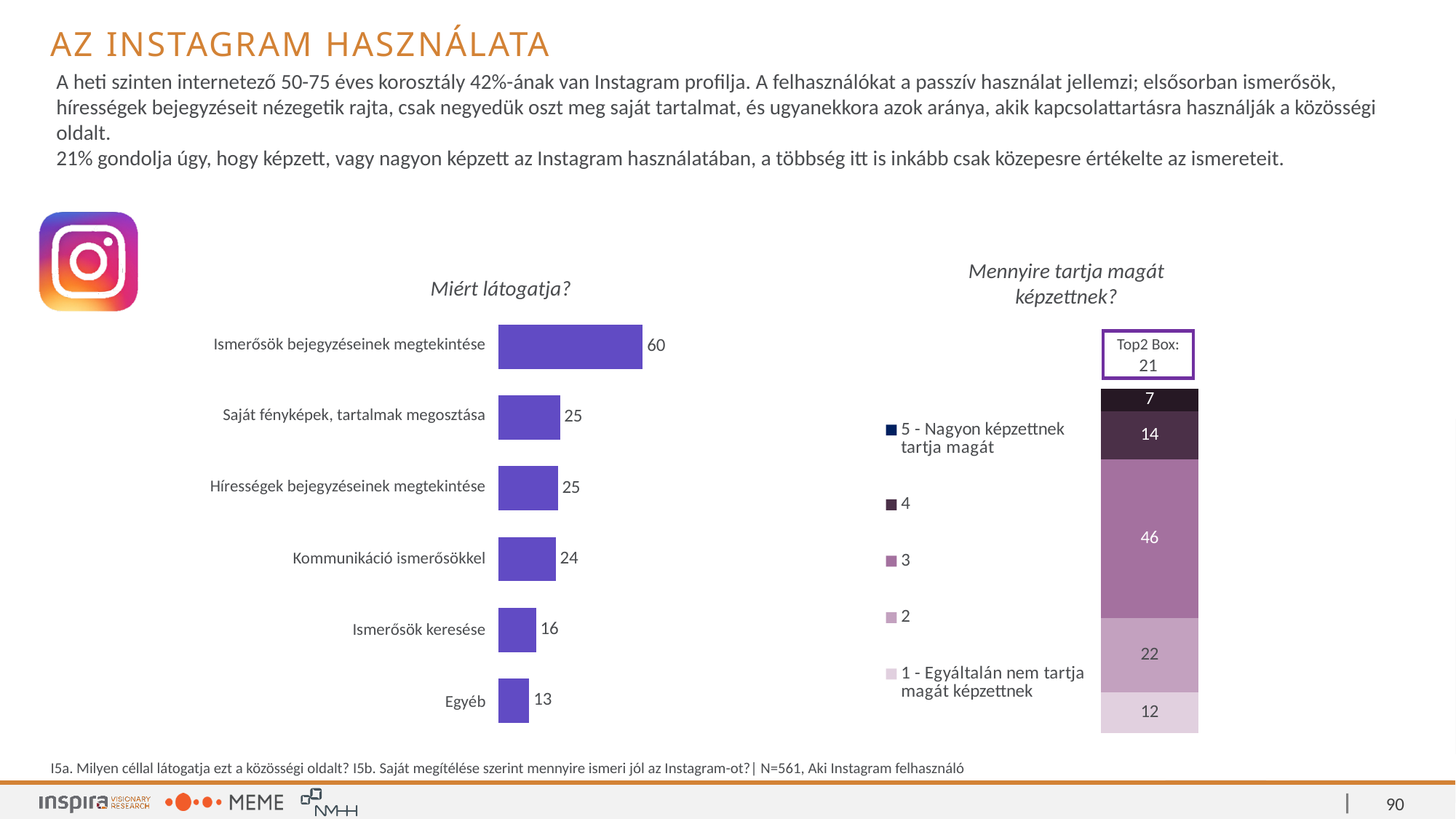
In the 'Miért látogatja?' chart, what is the difference between 'Ismerősök bejegyzéseinek megtekintése' and 'Saját fényképek, tartalmak megosztása'? 35 In the 'Miért látogatja?' chart, what is the value for 'Ismerősök keresése'? 16 In the 'Mennyire tartja magát képzettnek?' chart, what is the value of the '3' segment? 46 How many series does the legend of the 'Mennyire tartja magát képzettnek?' chart list? 5 How many categories are shown in the 'Miért látogatja?' chart? 6 In the 'Miért látogatja?' chart, which is larger: 'Kommunikáció ismerősökkel' or 'Egyéb'? Kommunikáció ismerősökkel In the 'Miért látogatja?' chart, what is the value for 'Ismerősök bejegyzéseinek megtekintése'? 60 What kind of chart is the 'Miért látogatja?' chart? Bar chart What is the Top2 Box value shown above the 'Mennyire tartja magát képzettnek?' chart? 21 In the 'Mennyire tartja magát képzettnek?' chart, what is the value for '5 - Nagyon képzettnek tartja magát'? 7 In the 'Miért látogatja?' chart, which category has the lowest value? Egyéb In the 'Miért látogatja?' chart, which category has the highest value? Ismerősök bejegyzéseinek megtekintése